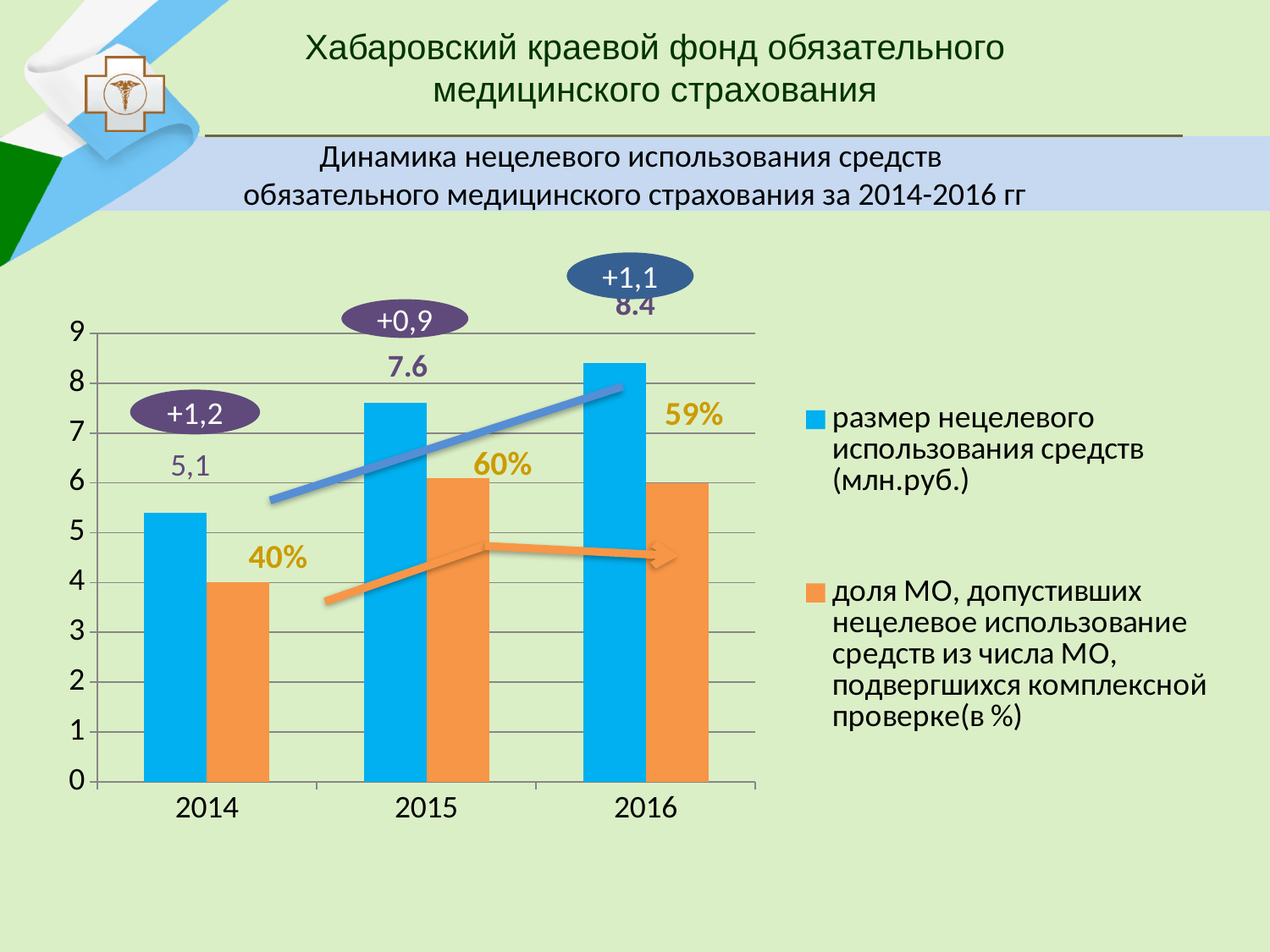
In which year is the размер нецелевого использования средств the highest? 2016 Does the размер нецелевого использования средств rise or fall from 2014 to 2016? rises How many series does the chart legend list? 2 What kind of chart is shown on the slide? bar chart What is the share of МО that allowed misuse of funds (доля МО) in 2014? 40% What is the share of МО that allowed misuse of funds (доля МО) in 2016? 59% What is the value of "размер нецелевого использования средств (млн.руб.)" for 2016? 8.4 What is the value of "размер нецелевого использования средств (млн.руб.)" for 2015? 7.6 In which year is the доля МО, допустивших нецелевое использование средств, the lowest? 2014 What is the value of "размер нецелевого использования средств (млн.руб.)" for 2014? 5,1 What is the share of МО that allowed misuse of funds (доля МО) in 2015? 60% How many years are shown on the x axis of the chart? 3